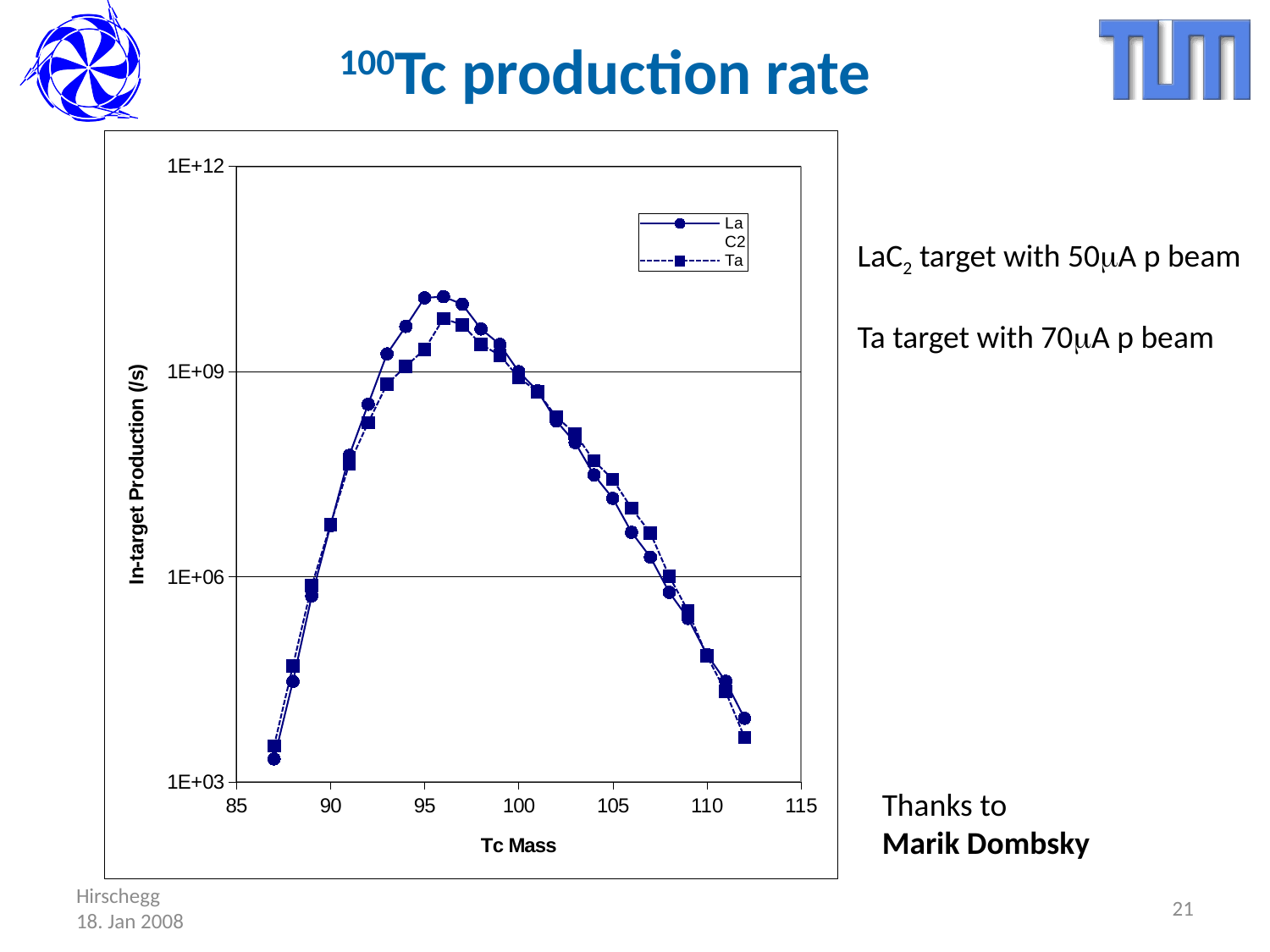
At Tc mass 105, which series has the higher in-target production, LaC2 or Ta? Ta Do the values rise or fall as Tc mass increases from 100 to 112? fall How many series does the legend list? 2 At Tc mass 95, which series has the higher in-target production, LaC2 or Ta? LaC2 Is the LaC2 value at Tc mass 105 greater or less than 1E+09? less Do the values rise or fall as Tc mass increases from 87 to 93? rise What is the title of the x axis? Tc Mass Is the Ta value at Tc mass 110 greater or less than 1E+06? less What kind of chart is shown on the slide? line chart Is the LaC2 value at Tc mass 95 greater or less than 1E+09? greater What are the two series named in the legend? LaC2 and Ta